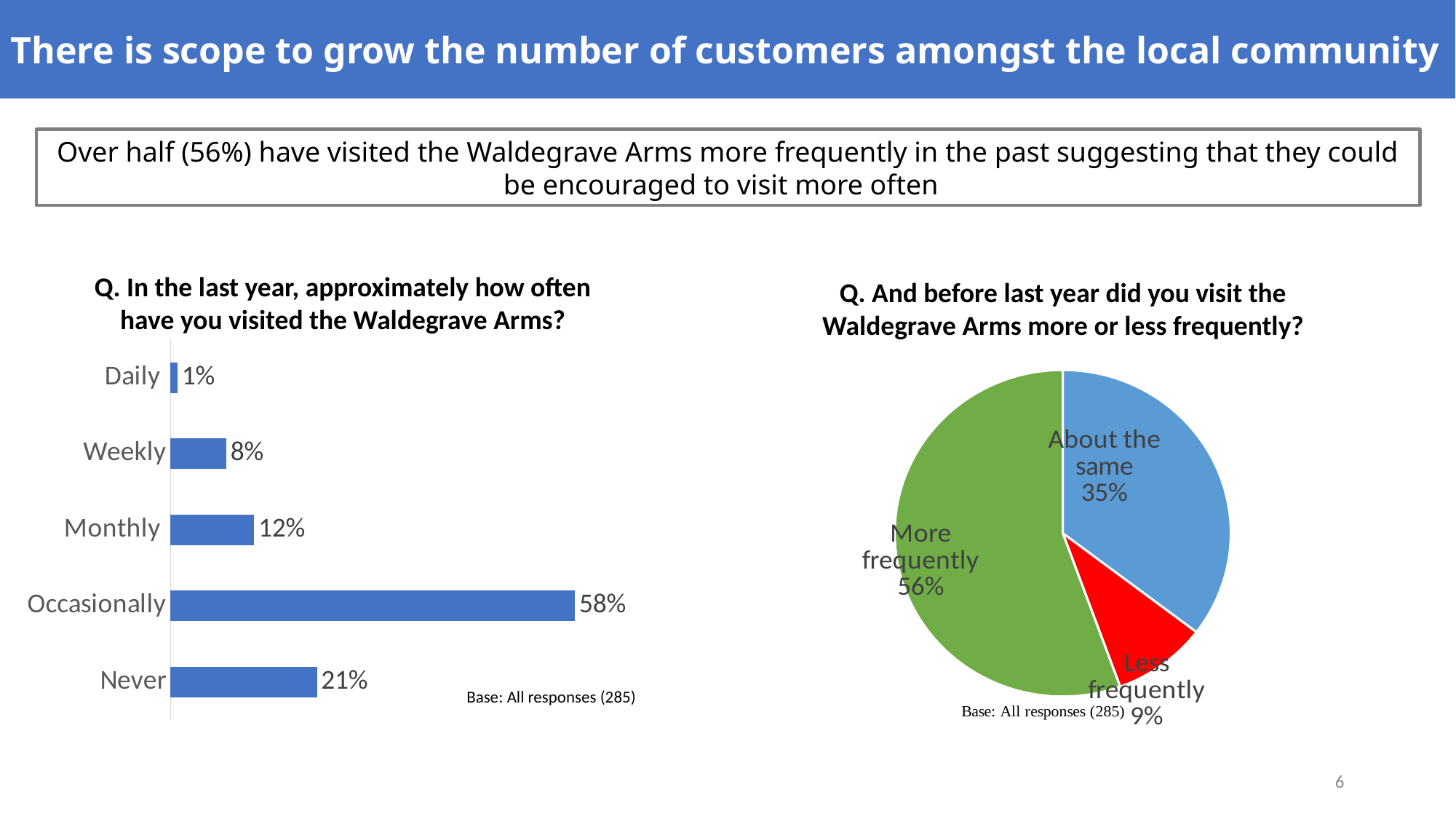
In the bar chart on the left, what is the value for Weekly? 8% In the bar chart on the left, what is the difference between the Occasionally and Never values? 37% In the bar chart on the left, what percentage of respondents visited the Waldegrave Arms Occasionally in the last year? 58% In the bar chart on the left, which category has the lowest value? Daily In the pie chart on the right, which slice is the largest? More frequently In the pie chart on the right, what share of respondents visited More frequently before last year? 56% In the pie chart on the right, what is the value for Less frequently? 9% In the pie chart on the right, what colour is the About the same slice? Blue In the bar chart on the left, which category has the highest value? Occasionally How many categories are shown in the bar chart on the left? 5 What kind of chart is the chart on the left? Bar chart In the bar chart on the left, which is larger, the value for Monthly or the value for Weekly? Monthly